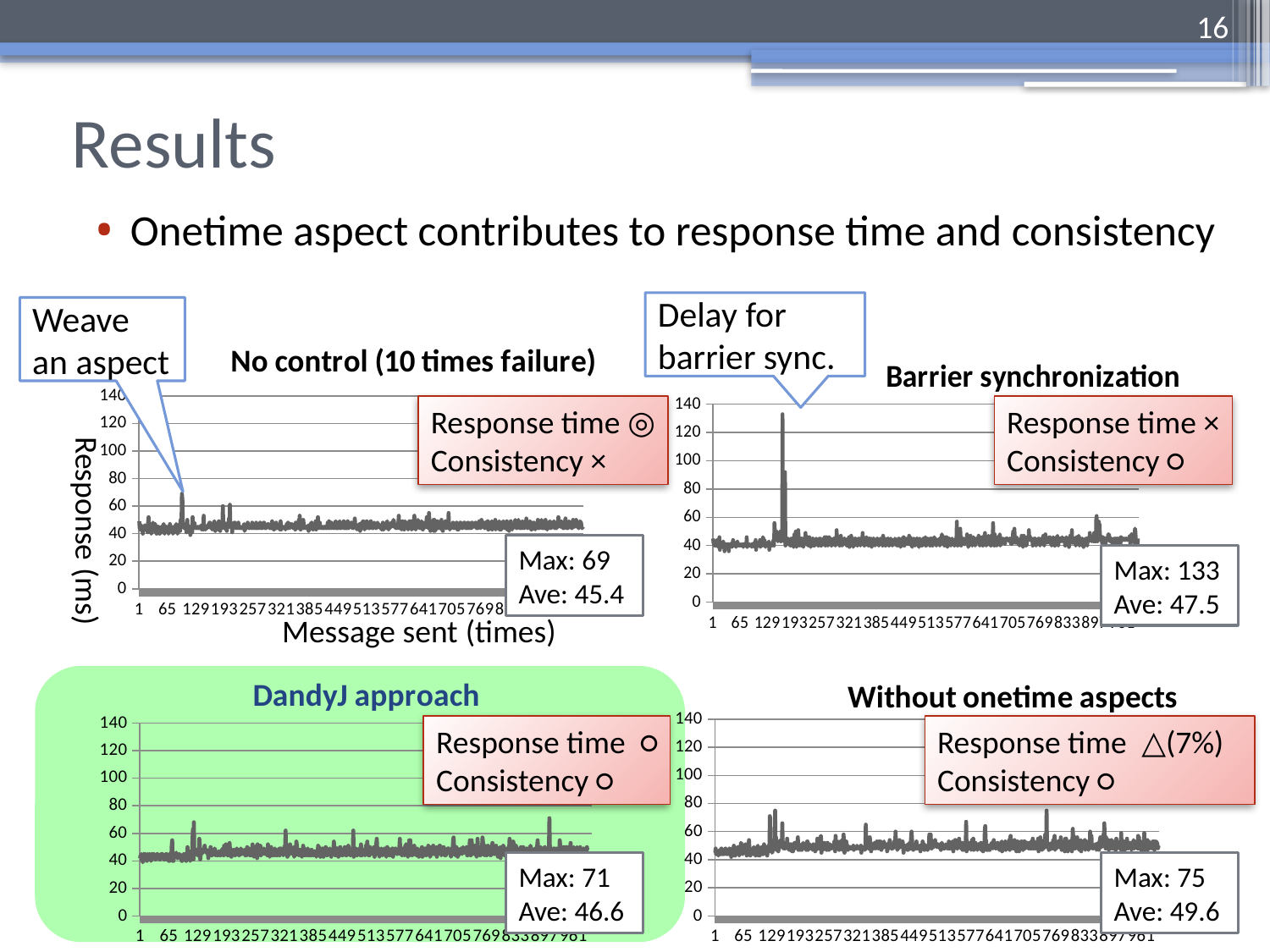
How many charts are shown on the slide? 4 Which of the four charts reports the highest maximum response time? Barrier synchronization In the "DandyJ approach" chart, what is the maximum response time stated in the annotation? 71 In the "No control (10 times failure)" chart, what is the maximum response time stated in the annotation? 69 In the "Barrier synchronization" chart, is the value at the tallest spike greater or less than 120? greater Which of the four charts reports the lowest average response time? No control (10 times failure) What kind of chart is the "No control (10 times failure)" chart? line chart What is the y-axis label of the "No control (10 times failure)" chart? Response (ms) Is the average response time higher in the "Without onetime aspects" chart or in the "DandyJ approach" chart? Without onetime aspects What is the difference between the maximum response time in the "Barrier synchronization" chart and the maximum in the "DandyJ approach" chart? 62 In the "Without onetime aspects" chart, what is the average response time stated in the annotation? 49.6 In the "Barrier synchronization" chart, what is the average response time stated in the annotation? 47.5